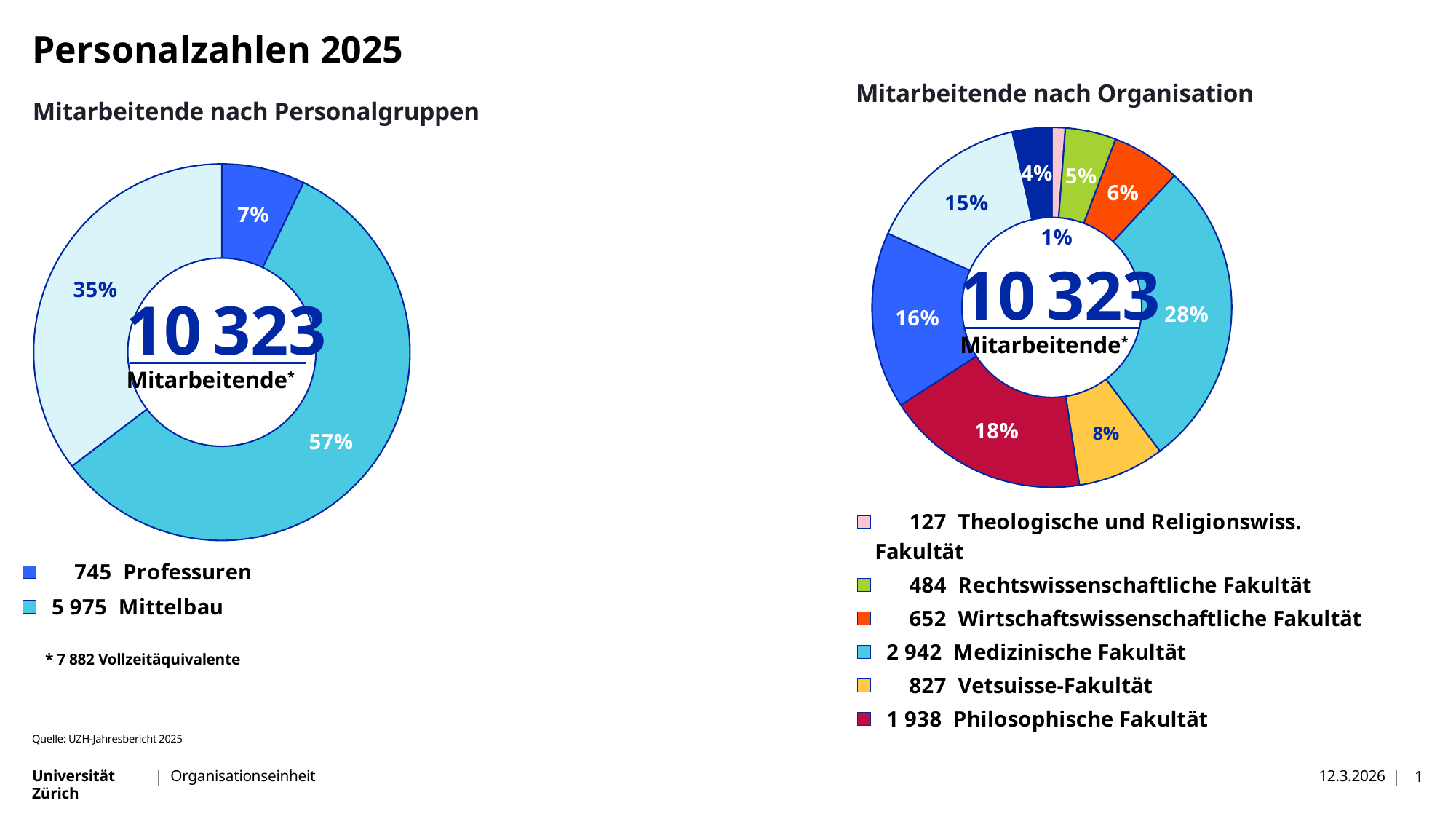
In the chart 'Mitarbeitende nach Personalgruppen', how many Professuren does the legend list? 745 In the chart 'Mitarbeitende nach Personalgruppen', how many Mittelbau does the legend list? 5 975 In the chart 'Mitarbeitende nach Organisation', which faculty listed in the legend has the most Mitarbeitende? Medizinische Fakultät In the chart 'Mitarbeitende nach Personalgruppen', what percentage share is shown for Professuren? 7% In the chart 'Mitarbeitende nach Organisation', what is the difference between the Medizinische Fakultät and the Philosophische Fakultät? 1 004 In the chart 'Mitarbeitende nach Organisation', which faculty listed in the legend has the fewest Mitarbeitende? Theologische und Religionswiss. Fakultät What total number of Mitarbeitende is shown in the centre of the chart 'Mitarbeitende nach Organisation'? 10 323 How many entries does the legend of the chart 'Mitarbeitende nach Organisation' list? 6 In the chart 'Mitarbeitende nach Organisation', how many Mitarbeitende does the Philosophische Fakultät have? 1 938 In the chart 'Mitarbeitende nach Organisation', how many Mitarbeitende does the Medizinische Fakultät have? 2 942 In the chart 'Mitarbeitende nach Personalgruppen', what percentage share is shown for Mittelbau? 57% What kind of chart is 'Mitarbeitende nach Personalgruppen'? doughnut chart